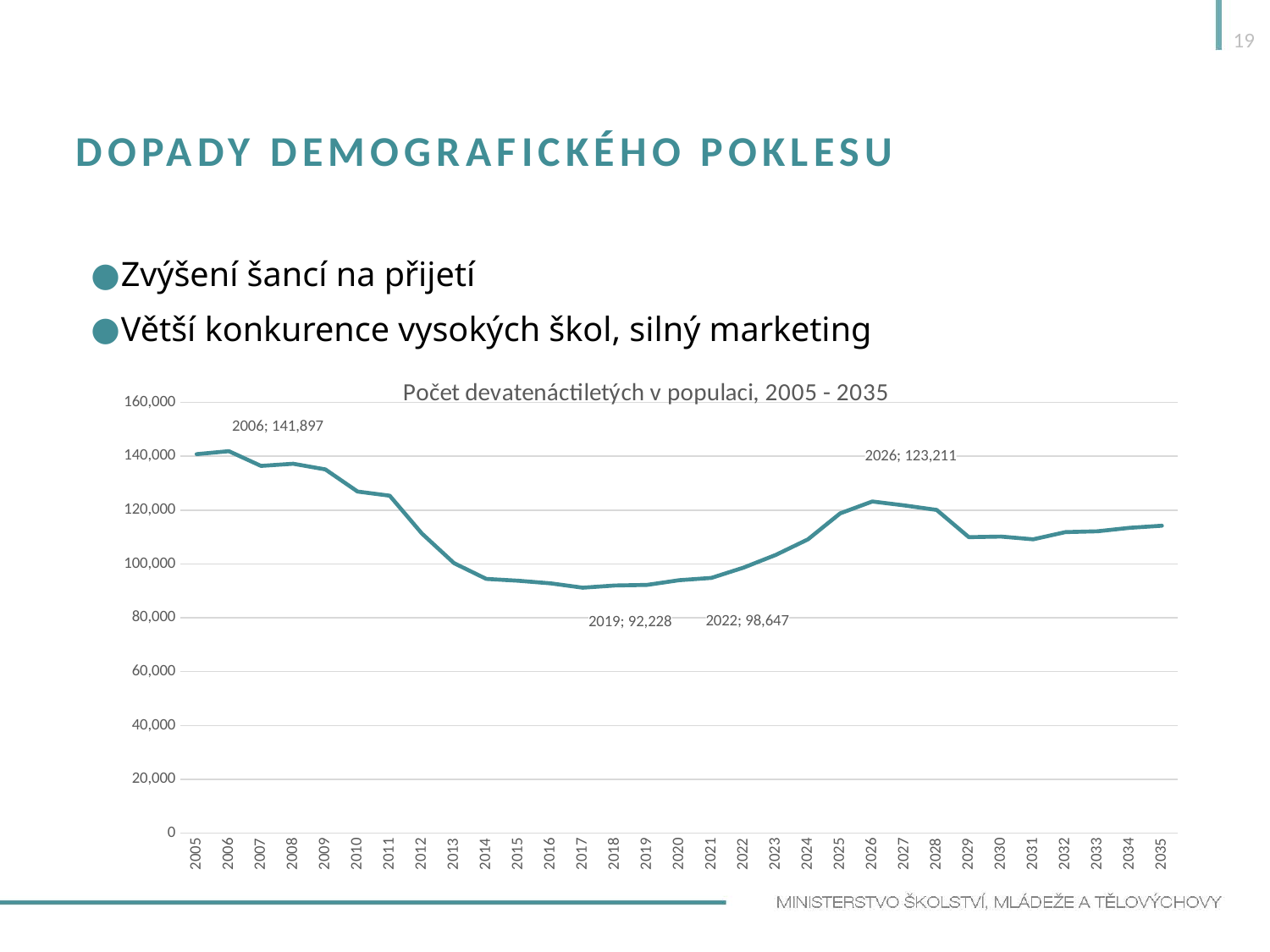
What is the value for 2026? 123,211 What is the value for 2006? 141,897 Which is larger, the value for 2019 or the value for 2022? 2022 What is the value for 2019? 92,228 What is the title of the chart? Počet devatenáctiletých v populaci, 2005 - 2035 Is the value for 2017 greater or less than 100,000? less What is the difference between the values for 2026 and 2019? 30,983 What is the value for 2022? 98,647 Do the values rise or fall from 2006 to 2017? fall What kind of chart is shown on the slide? line chart What is the difference between the values for 2006 and 2026? 18,686 Is the value for 2010 greater or less than 120,000? greater